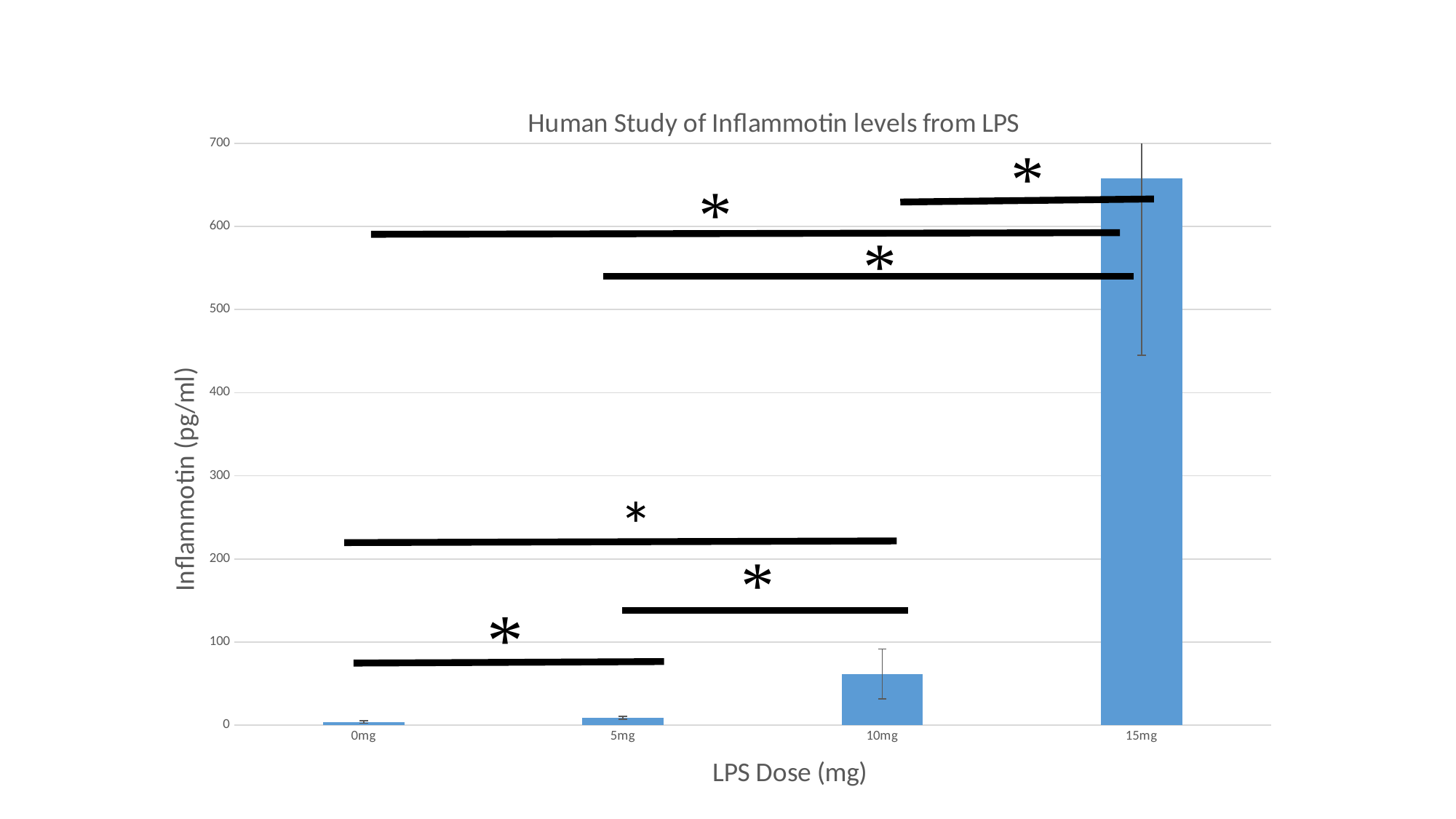
Do the Inflammotin levels rise or fall as the LPS dose increases along the x axis? rise How many LPS dose categories are plotted on the x axis? 4 Is the Inflammotin value for 15mg greater or less than 600? greater Which has a higher Inflammotin level, 5mg or 10mg? 10mg Which LPS dose has the highest Inflammotin level? 15mg Which has a higher Inflammotin level, 10mg or 15mg? 15mg Which LPS dose has the lowest Inflammotin level? 0mg What is the title of the chart? Human Study of Inflammotin levels from LPS What kind of chart is shown on the slide? bar chart Is the Inflammotin value for 15mg greater or less than 700? less Is the Inflammotin value for 10mg greater or less than 100? less What is the label of the y axis? Inflammotin (pg/ml)